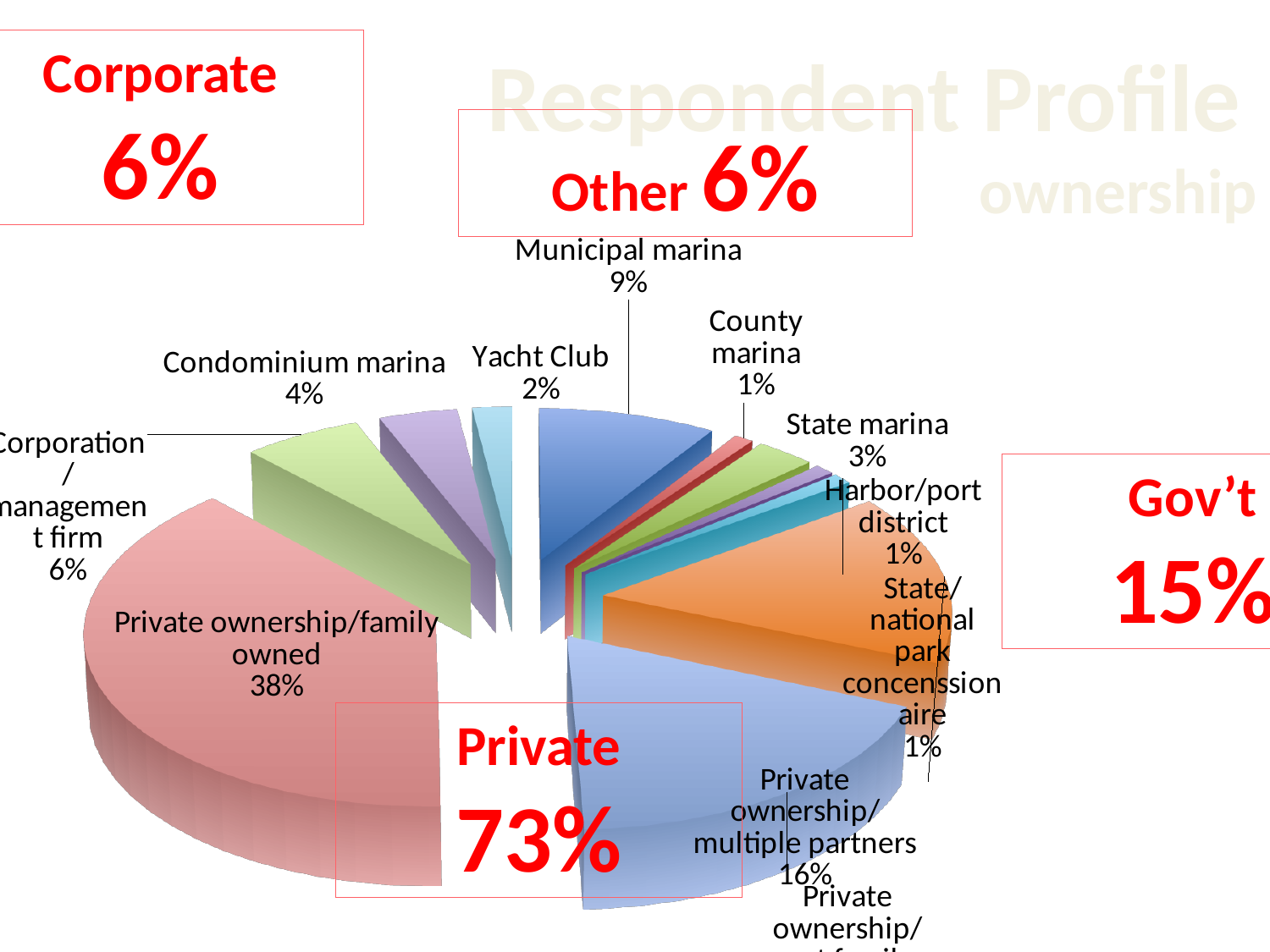
According to the overlay box, what total share is labelled Gov't? 15% What kind of chart is shown on the slide? pie chart What share of respondents is Private ownership/family owned? 38% What percentage is shown for State marina? 3% What is the difference in percentage points between Municipal marina and State marina? 6 percentage points What percentage is shown for Private ownership/multiple partners? 16% According to the overlay box, what total share is labelled Private? 73% What percentage is shown for Municipal marina? 9% Which category has the largest slice of the pie? Private ownership/family owned What percentage is shown for Condominium marina? 4% Which is larger, Condominium marina or Yacht Club? Condominium marina What is the difference in percentage points between Private ownership/family owned and Private ownership/multiple partners? 22 percentage points